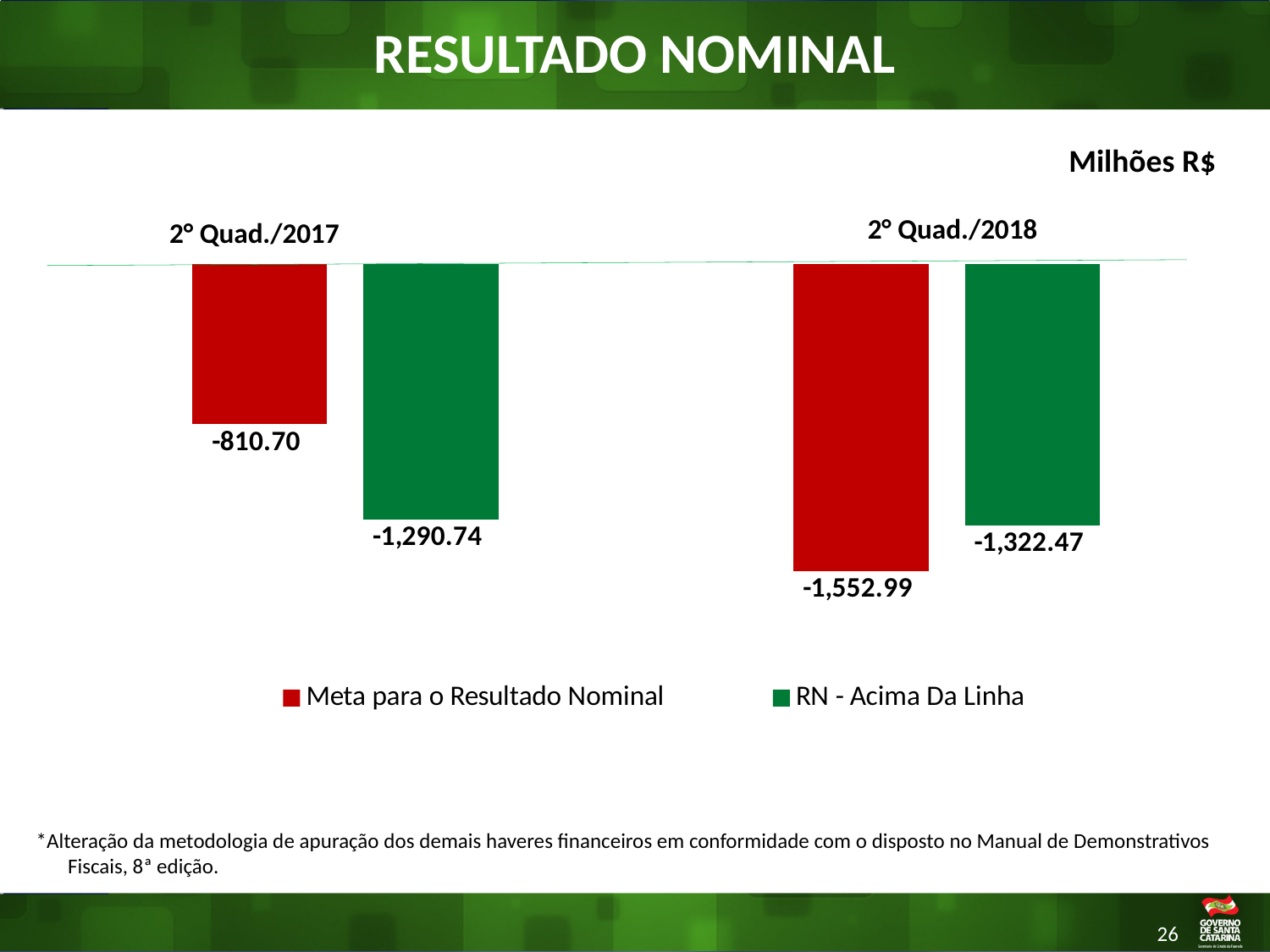
Which is numerically greater for 2º Quad./2018: 'Meta para o Resultado Nominal' or 'RN - Acima Da Linha'? RN - Acima Da Linha What is the value of 'RN - Acima Da Linha' for 2º Quad./2017? -1,290.74 What unit is indicated for the values on the chart? Milhões R$ Which bar has the lowest (most negative) value on the chart? Meta para o Resultado Nominal, 2º Quad./2018 What is the difference between the 'Meta para o Resultado Nominal' and 'RN - Acima Da Linha' values for 2º Quad./2018? 230.52 What is the value of 'Meta para o Resultado Nominal' for 2º Quad./2018? -1,552.99 What is the value of 'RN - Acima Da Linha' for 2º Quad./2018? -1,322.47 Which bar has the highest (least negative) value on the chart? Meta para o Resultado Nominal, 2º Quad./2017 What is the difference between the 'Meta para o Resultado Nominal' and 'RN - Acima Da Linha' values for 2º Quad./2017? 480.04 What kind of chart is shown on the slide? Bar chart How many series does the legend list? 2 What is the value of 'Meta para o Resultado Nominal' for 2º Quad./2017? -810.70